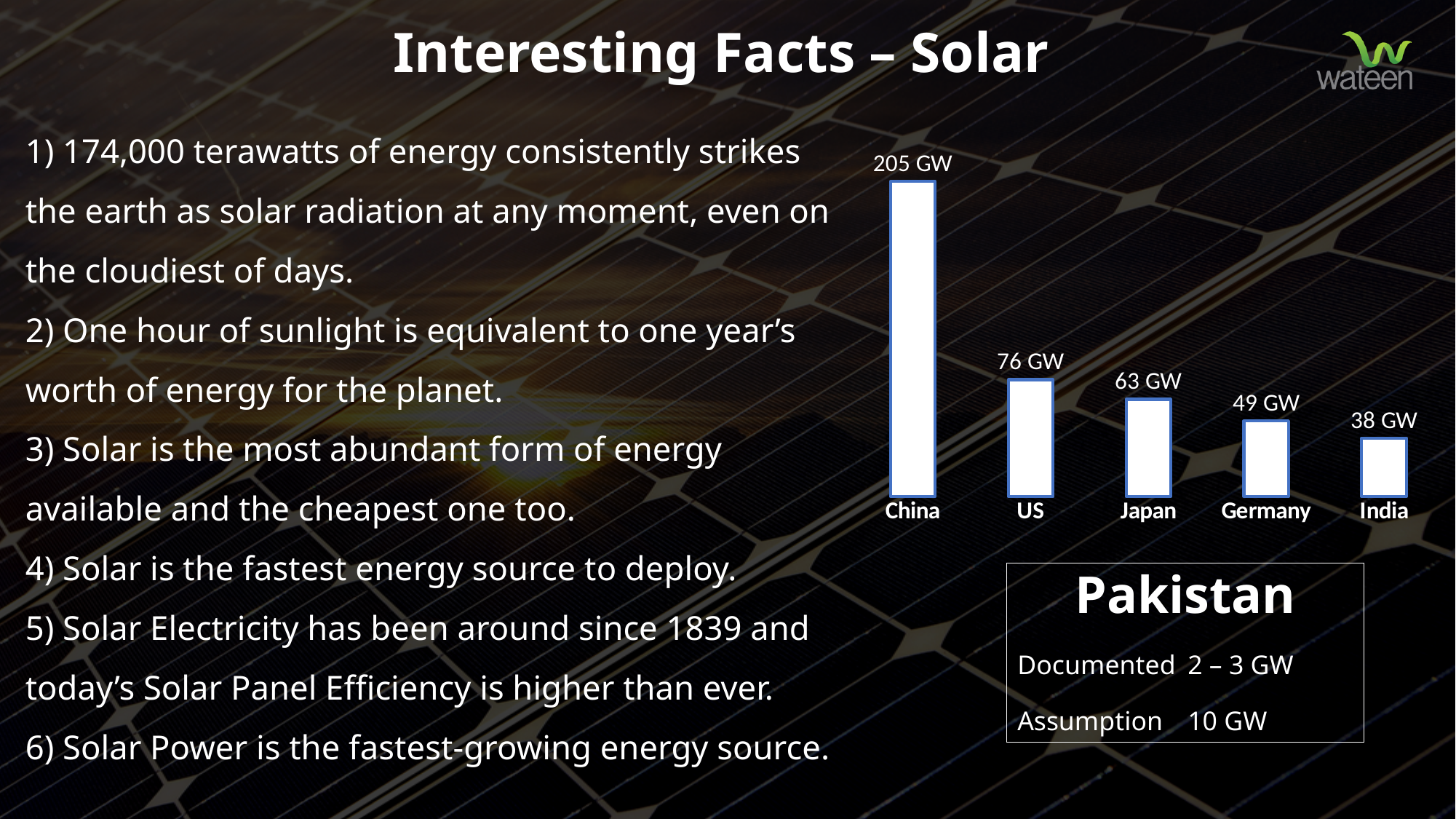
What is the value for Japan in the bar chart? 63 GW Which country has the highest value in the bar chart? China What is the value for India in the bar chart? 38 GW What is the difference between the values for China and the US? 129 GW Do the values rise or fall from China to India along the x axis? Fall What is the value for China in the bar chart? 205 GW Which country has the lowest value in the bar chart? India What is the value for Germany in the bar chart? 49 GW How many countries are shown in the bar chart? 5 What kind of chart is shown on the slide? Bar chart What is the difference between the values for Germany and India? 11 GW Which has a larger value, the US or Japan? US